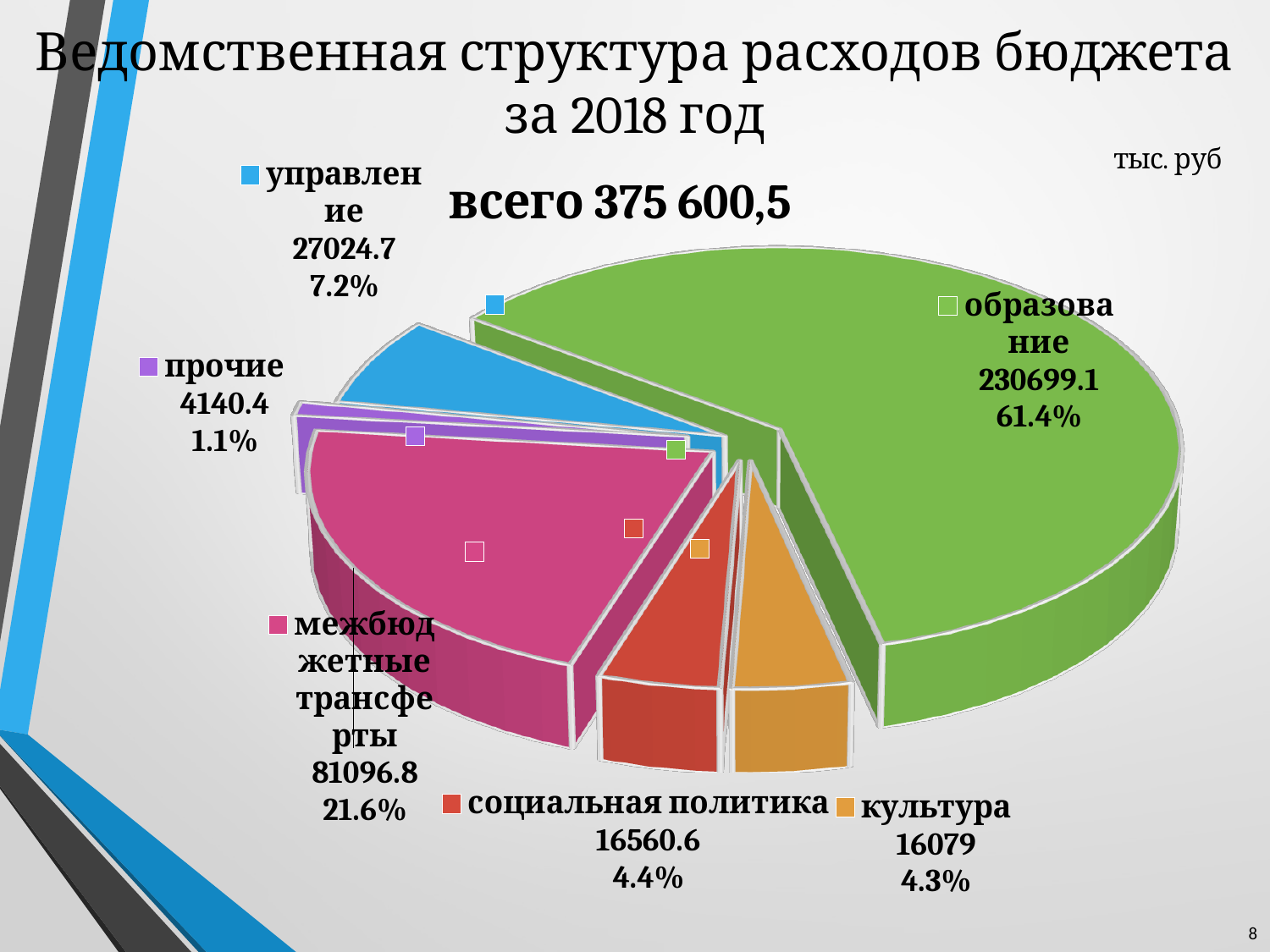
What unit is indicated in the top right corner of the chart? тыс. руб What kind of chart is shown on the slide? pie chart Which category has the smallest slice? прочие What is the value for межбюджетные трансферты? 81096.8 What share of the pie does образование take? 61.4% How many slices does the pie chart have? 6 Which category has the largest slice? образование What is the difference between the values for управление and прочие? 22884.3 Which is larger, социальная политика or культура? социальная политика What total is stated above the pie chart? 375 600,5 What is the value for образование? 230699.1 What share of the pie does управление take? 7.2%